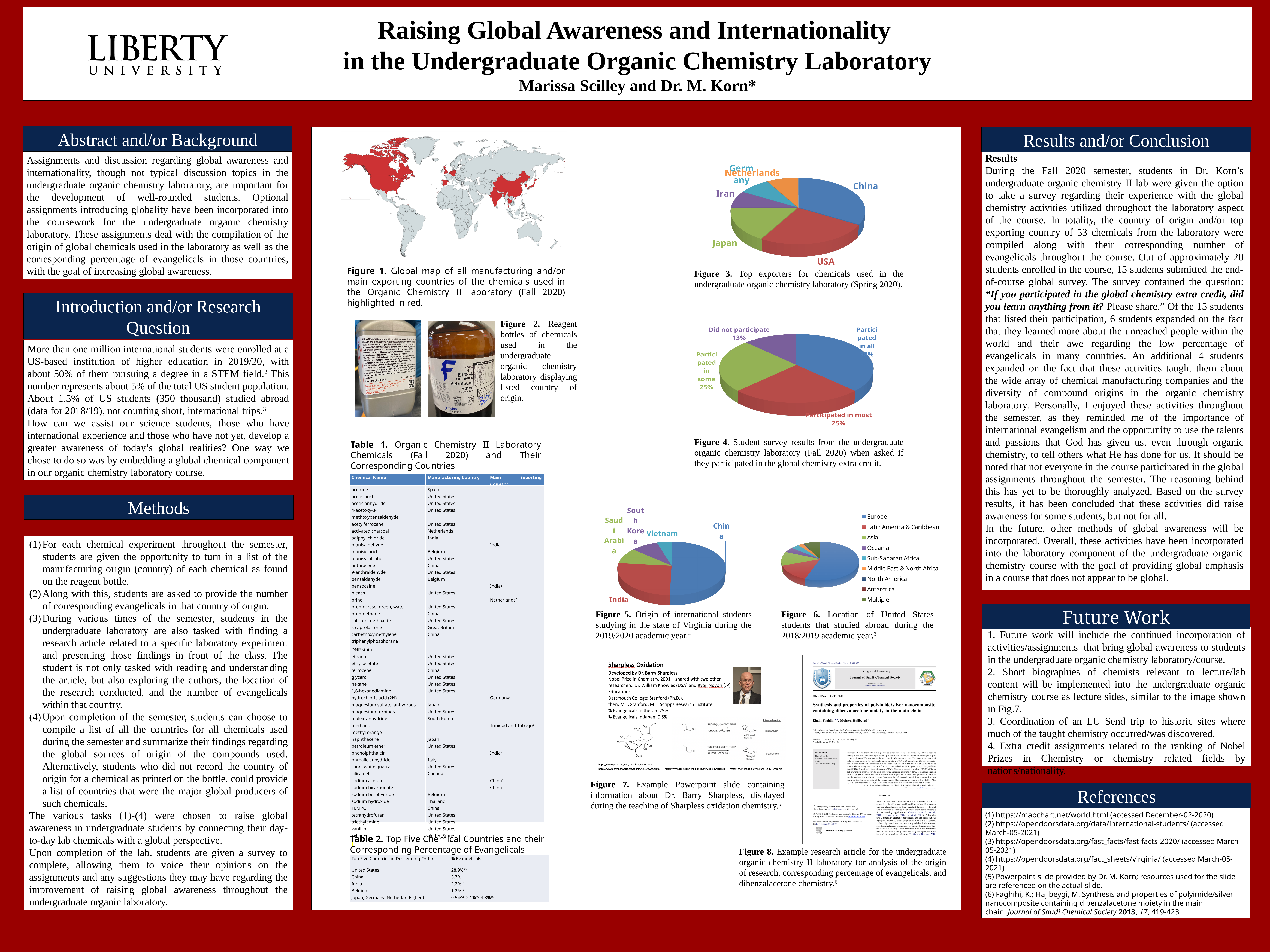
In Figure 4, which response category has the largest share of the pie? Participated in all In Figure 4, which response category has the smallest share of the pie? Did not participate In Figure 4, what percentage of students participated in most of the global chemistry extra credit? 25% What kind of chart is Figure 3? Pie chart How many regions does the legend of Figure 6 list? 9 In Figure 4, what percentage of students did not participate in the global chemistry extra credit? 13% In Figure 3, which country has the largest slice of the pie? China How many response categories are shown in the Figure 4 pie chart? 4 In Figure 3, which slice is larger, USA or Japan? USA In Figure 5, which country has the largest slice of the pie? China In Figure 4, what percentage of students participated in some of the global chemistry extra credit? 25% In Figure 4, what is the difference between the share that participated in most and the share that did not participate? 12%